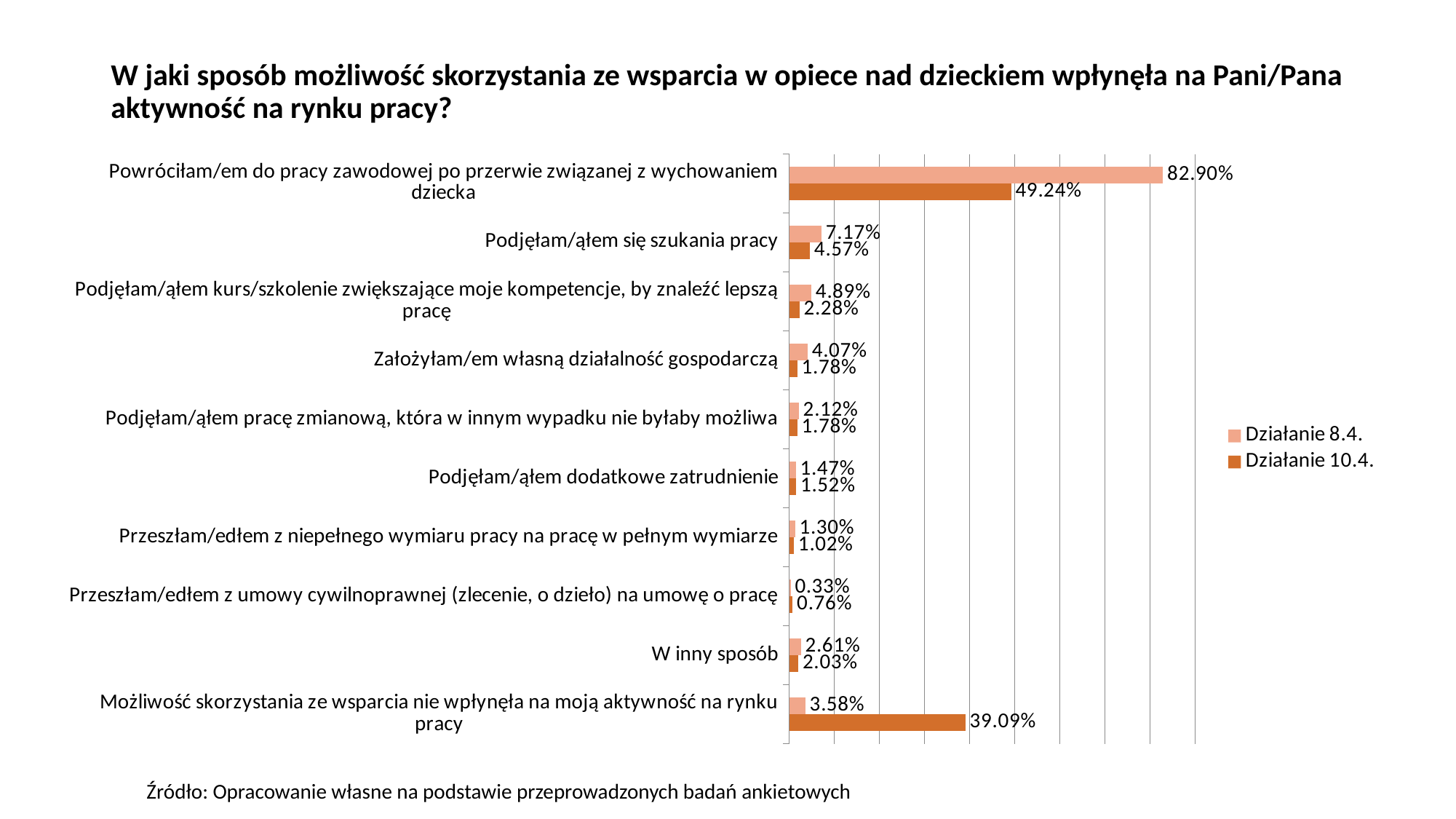
Which category has the lowest value for Działanie 8.4.? Przeszłam/edłem z umowy cywilnoprawnej (zlecenie, o dzieło) na umowę o pracę What is the value for Działanie 8.4. in the category "Powróciłam/em do pracy zawodowej po przerwie związanej z wychowaniem dziecka"? 82.90% Which series is shown in the darker orange colour? Działanie 10.4. What is the difference between Działanie 8.4. and Działanie 10.4. in the category "Powróciłam/em do pracy zawodowej po przerwie związanej z wychowaniem dziecka"? 33.66% How many series does the legend list? 2 In the category "Możliwość skorzystania ze wsparcia nie wpłynęła na moją aktywność na rynku pracy", which series has the larger value, Działanie 8.4. or Działanie 10.4.? Działanie 10.4. What type of chart is shown on the slide? Bar chart How many categories are shown on the chart? 10 What is the value for Działanie 8.4. in the category "W inny sposób"? 2.61% What is the value for Działanie 10.4. in the category "Podjęłam/ąłem się szukania pracy"? 4.57% Which category has the highest value for Działanie 8.4.? Powróciłam/em do pracy zawodowej po przerwie związanej z wychowaniem dziecka What is the value for Działanie 10.4. in the category "Możliwość skorzystania ze wsparcia nie wpłynęła na moją aktywność na rynku pracy"? 39.09%